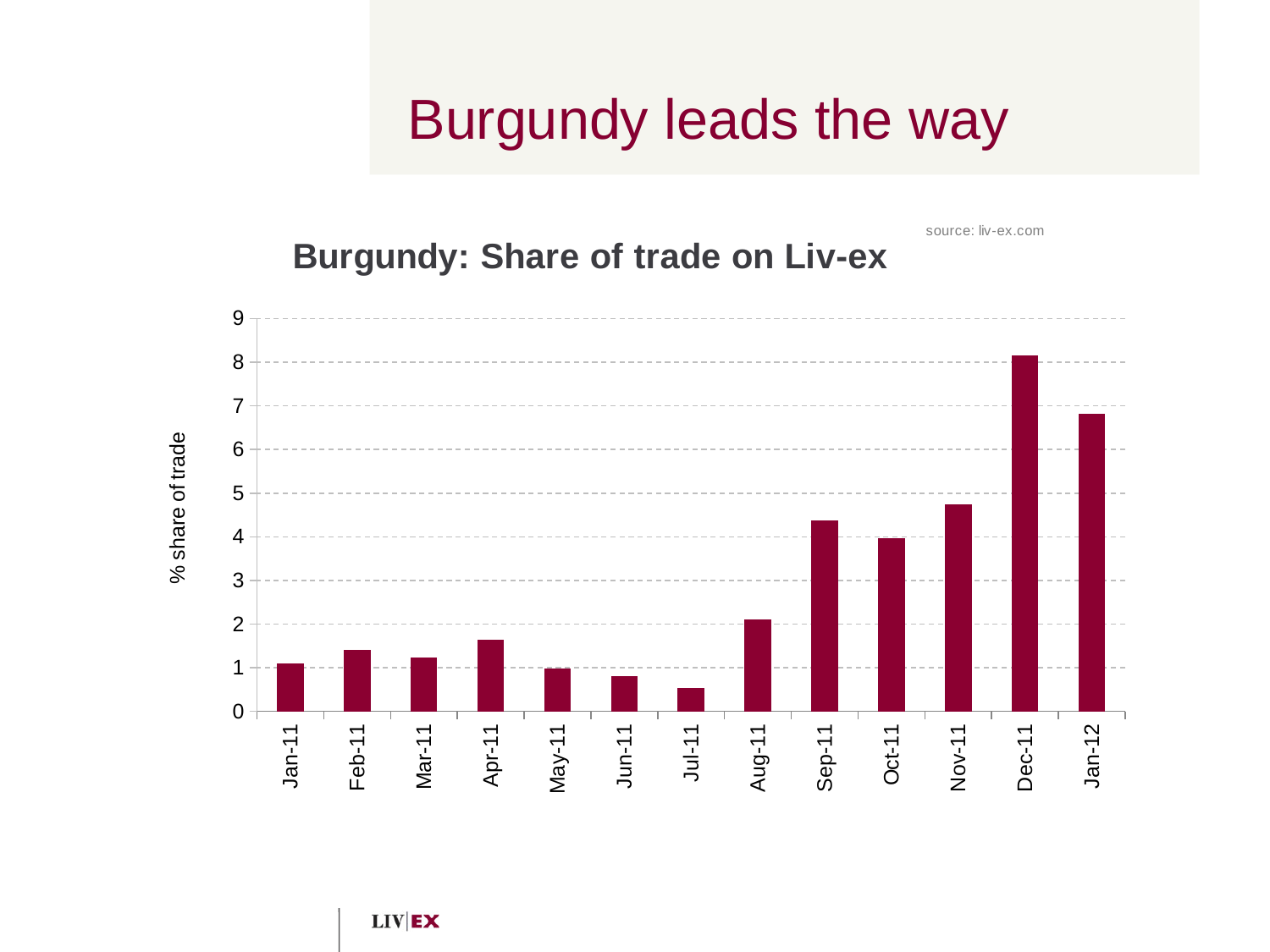
Which month has the highest share of trade? Dec-11 What kind of chart is shown on the slide? bar chart Is the value for Dec-11 greater or less than 8? greater Which is larger, the value for Dec-11 or the value for Jan-12? Dec-11 What is the title of the chart? Burgundy: Share of trade on Liv-ex Which month has the lowest share of trade? Jul-11 Do the values rise or fall from Aug-11 to Dec-11? rise How many months are plotted on the x axis? 13 Which is larger, the value for Sep-11 or the value for Oct-11? Sep-11 Is the value for Sep-11 greater or less than 4? greater Is the value for Jul-11 greater or less than 1? less